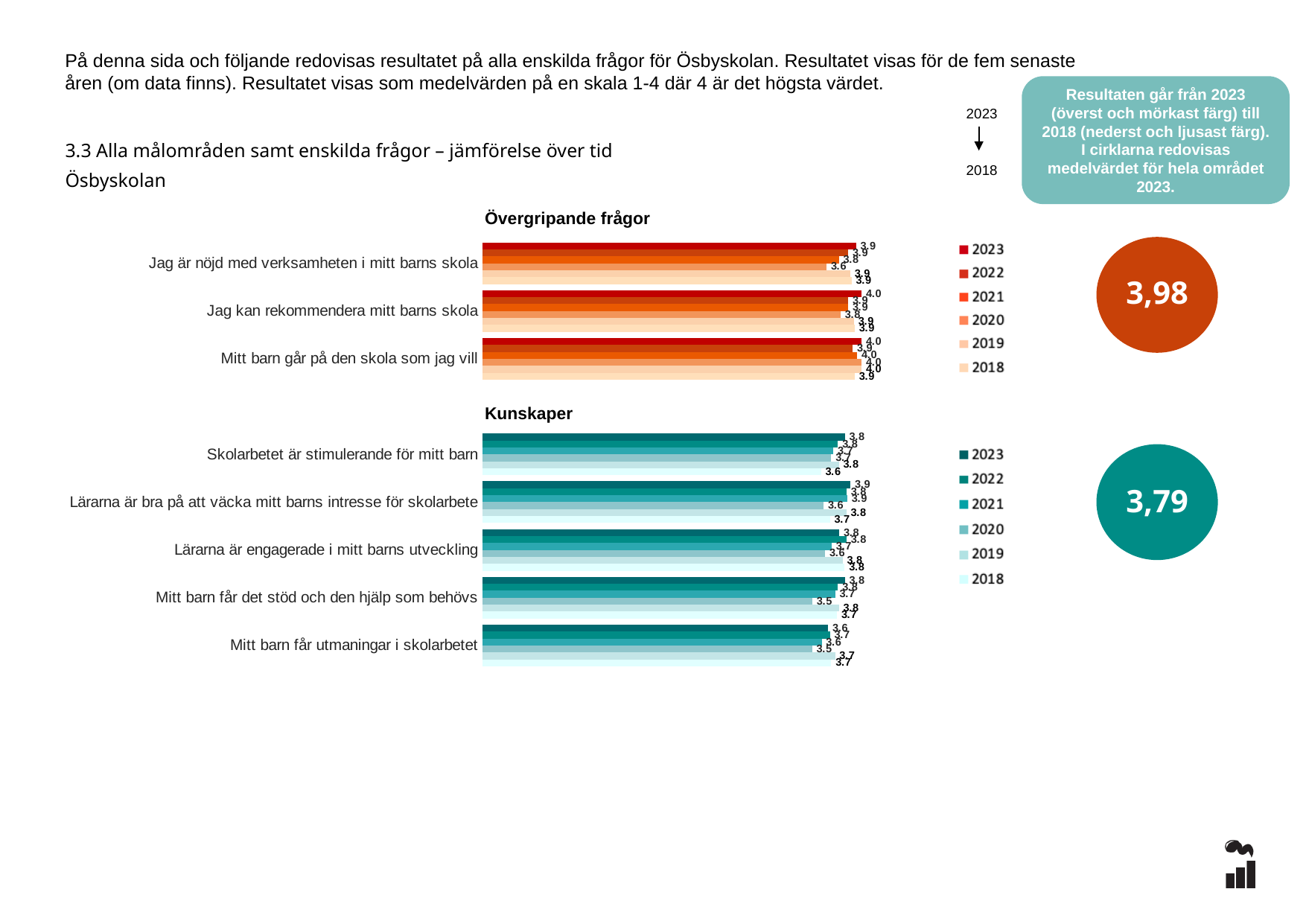
How many categories (questions) are shown in the 'Kunskaper' chart? 5 How many series does the legend of the 'Övergripande frågor' chart list? 6 How many categories (questions) are shown in the 'Övergripande frågor' chart? 3 In the 'Kunskaper' chart, what is the 2020 value for 'Mitt barn får det stöd och den hjälp som behövs'? 3.5 In the 'Övergripande frågor' chart, what is the 2020 value for 'Jag är nöjd med verksamheten i mitt barns skola'? 3.6 What kind of chart is the 'Kunskaper' chart? bar chart In the 'Kunskaper' chart, for 'Lärarna är bra på att väcka mitt barns intresse för skolarbete', which is larger: the 2023 value or the 2020 value? 2023 In the 'Kunskaper' chart, what is the 2018 value for 'Skolarbetet är stimulerande för mitt barn'? 3.6 In the 'Övergripande frågor' chart, what is the difference between the 2023 and 2020 values for 'Jag är nöjd med verksamheten i mitt barns skola'? 0.3 In the 'Kunskaper' chart, which year has the lowest value for 'Mitt barn får det stöd och den hjälp som behövs'? 2020 In the 'Övergripande frågor' chart, what is the 2023 value for 'Jag kan rekommendera mitt barns skola'? 4.0 What overall 2023 mean value is shown in the circle next to the 'Kunskaper' chart? 3,79